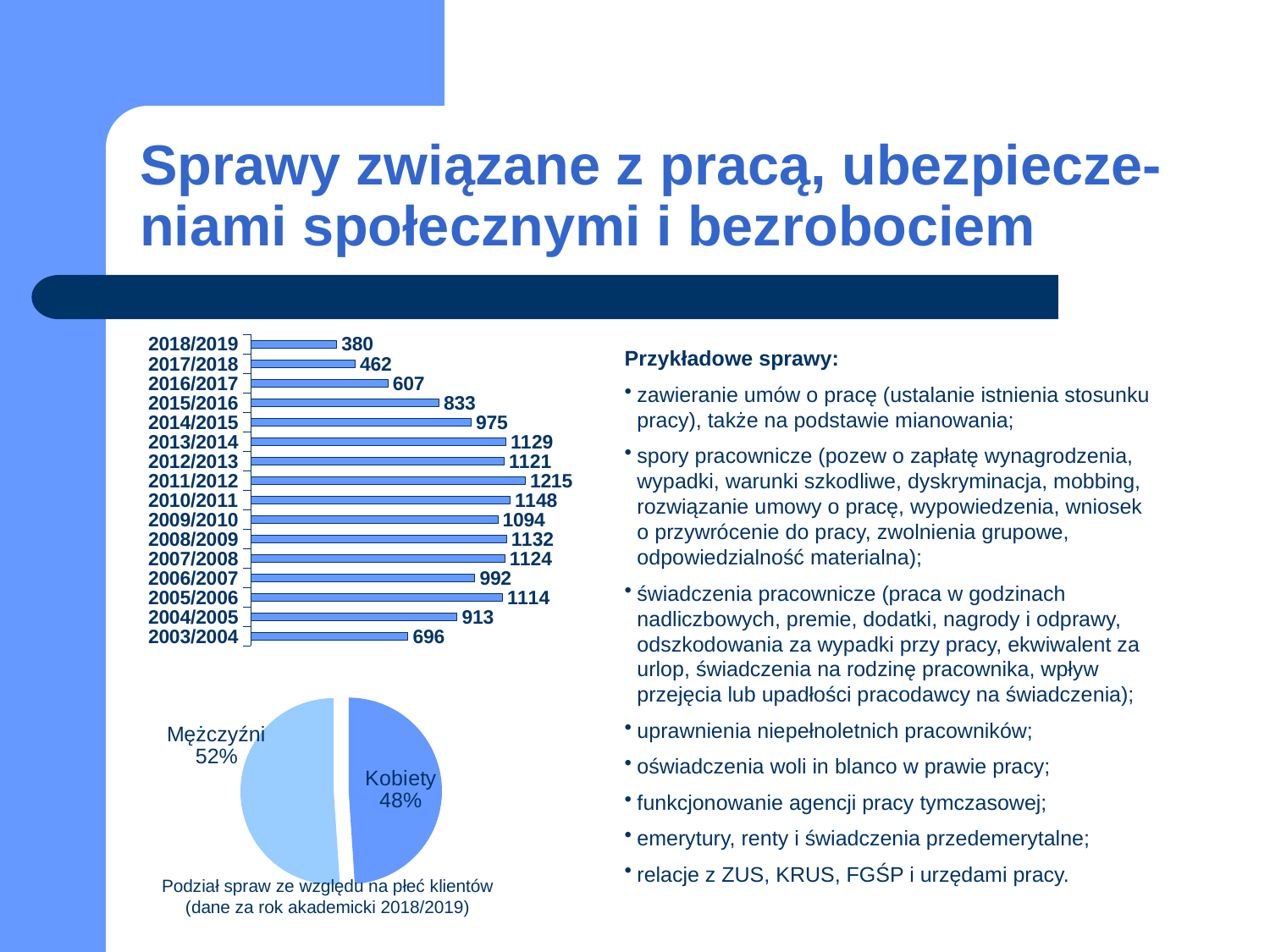
In the bar chart at the top left of the slide, what is the value for 2003/2004? 696 In the bar chart at the top left of the slide, which is larger: the value for 2014/2015 or the value for 2006/2007? 2006/2007 In the pie chart at the bottom left of the slide, which slice is larger: Mężczyźni or Kobiety? Mężczyźni In the bar chart at the top left of the slide, which academic year has the highest value? 2011/2012 How many academic years are shown in the bar chart at the top left of the slide? 16 In the bar chart at the top left of the slide, what is the value for 2011/2012? 1215 In the pie chart at the bottom left of the slide, what share is labelled Kobiety? 48% In the bar chart at the top left of the slide, what is the difference between the values for 2015/2016 and 2016/2017? 226 What kind of chart is the chart at the top left of the slide? bar chart In the bar chart at the top left of the slide, what is the value for 2018/2019? 380 In the bar chart at the top left of the slide, which academic year has the lowest value? 2018/2019 In the bar chart at the top left of the slide, do the values rise or fall from 2014/2015 to 2018/2019? fall